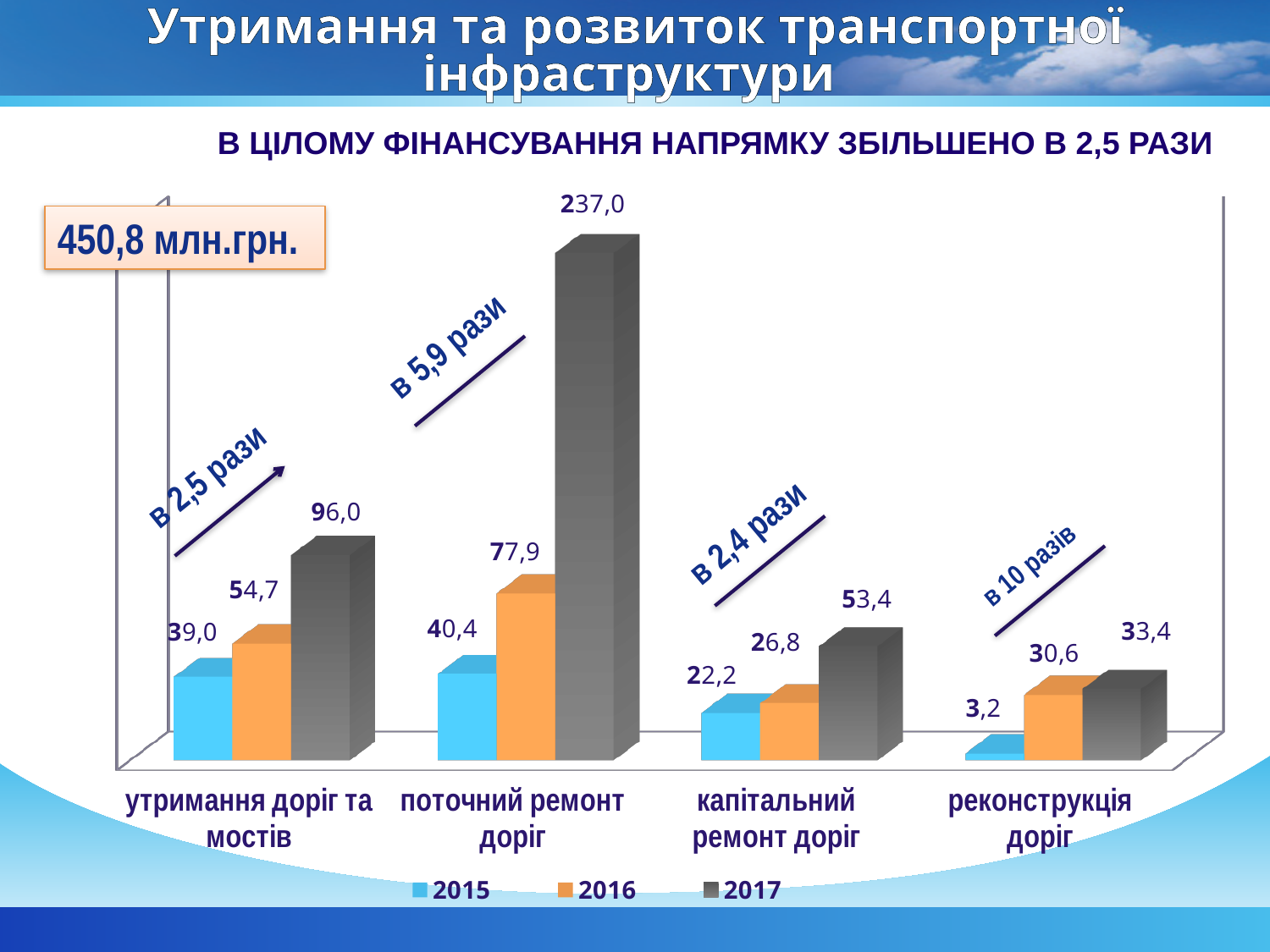
How many categories are shown on the x axis? 4 How many series does the legend list? 3 Which category has the highest value for 2017? поточний ремонт доріг What is the value for 2017 for капітальний ремонт доріг? 53,4 What is the value for 2016 for утримання доріг та мостів? 54,7 Which is larger: the 2016 value for поточний ремонт доріг or the 2016 value for капітальний ремонт доріг? поточний ремонт доріг Which category has the lowest value for 2015? реконструкція доріг Which series is shown in orange in the legend? 2016 What is the value for 2017 for поточний ремонт доріг? 237,0 What is the value for 2015 for реконструкція доріг? 3,2 What kind of chart is shown on the slide? bar chart What is the difference between the 2017 and 2015 values for утримання доріг та мостів? 57,0